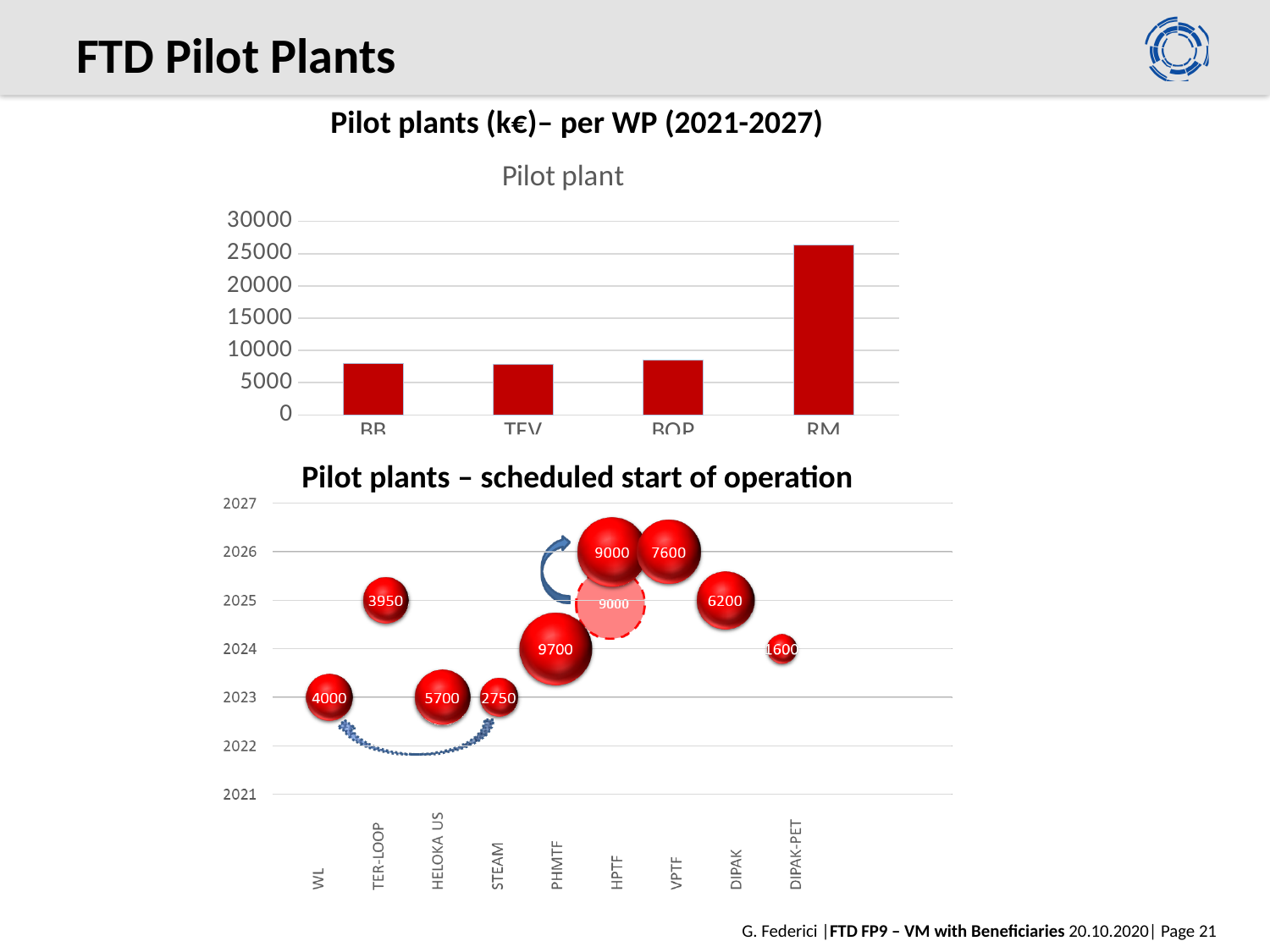
In the top chart titled "Pilot plant", which category has the highest bar? RM In the top chart titled "Pilot plant", is the value for BB greater or less than 10000? less In the top chart titled "Pilot plant", is the value for RM greater or less than 25000? greater In the bottom chart "Pilot plants – scheduled start of operation", which has the larger labelled value, VPTF or DIPAK? VPTF What kind of chart is the top chart titled "Pilot plant"? bar chart In the bottom chart "Pilot plants – scheduled start of operation", which pilot plant has the smallest labelled value? DIPAK-PET In the bottom chart "Pilot plants – scheduled start of operation", what value is labelled on the bubble for PHMTF? 9700 In the bottom chart "Pilot plants – scheduled start of operation", how many pilot plants are listed on the x axis? 9 In the bottom chart "Pilot plants – scheduled start of operation", what is the difference between the labelled values for HELOKA US and STEAM? 2950 In the bottom chart "Pilot plants – scheduled start of operation", what value is labelled on the bubble for DIPAK? 6200 In the top chart titled "Pilot plant", how many categories are shown on the x axis? 4 In the bottom chart "Pilot plants – scheduled start of operation", which pilot plant has the largest labelled value? PHMTF